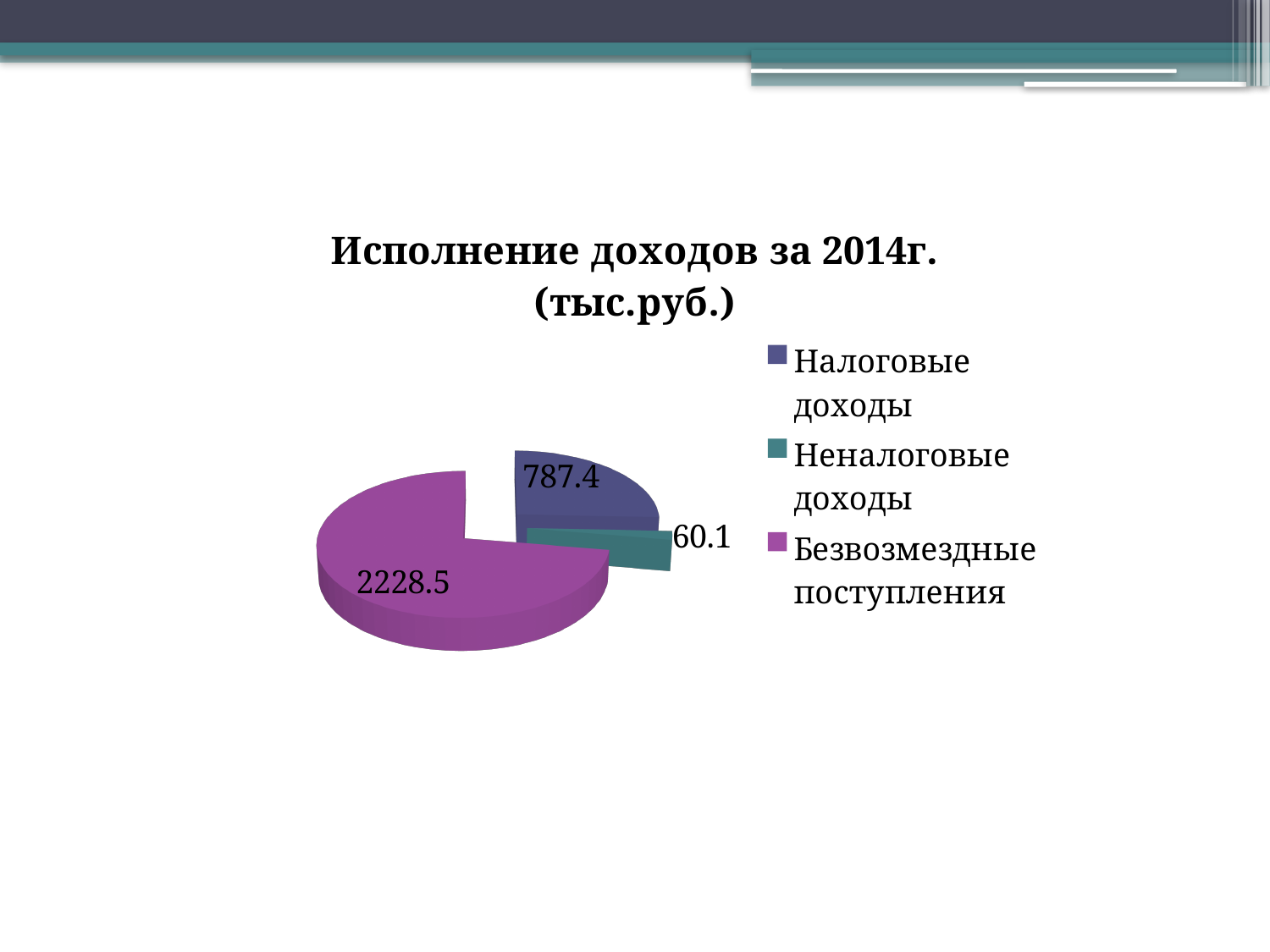
What is the difference between Налоговые доходы and Неналоговые доходы? 727.3 How many categories does the pie chart show? 3 What type of chart is shown on the slide? Pie chart Which category has the largest value? Безвозмездные поступления Which category has the smallest value? Неналоговые доходы What is the value for Неналоговые доходы? 60.1 What is the total of all slices in the pie chart? 3076.0 What is the difference between Безвозмездные поступления and Налоговые доходы? 1441.1 What is the value for Налоговые доходы? 787.4 What is the title of the chart? Исполнение доходов за 2014г. (тыс.руб.) What is the value for Безвозмездные поступления? 2228.5 Which is larger, Налоговые доходы or Неналоговые доходы? Налоговые доходы